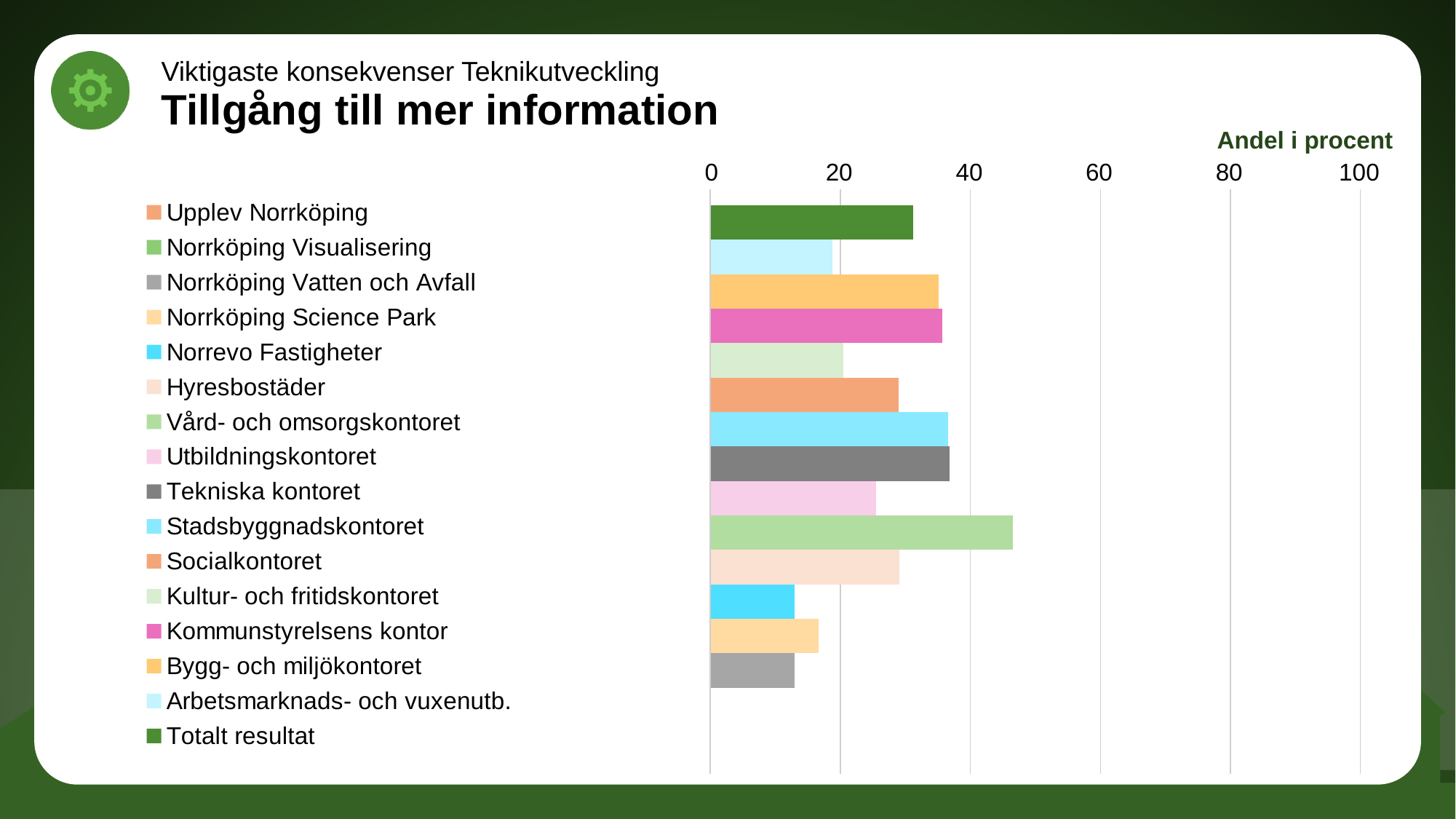
Is the value for Norrevo Fastigheter greater or less than 20? less Which series has the highest value in the chart? Vård- och omsorgskontoret Which is larger, the value for Vård- och omsorgskontoret or the value for Totalt resultat? Vård- och omsorgskontoret How many entries does the legend list? 16 What is the main title of the slide containing the chart? Tillgång till mer information Which is larger, the value for Socialkontoret or the value for Norrevo Fastigheter? Socialkontoret Is the value for Stadsbyggnadskontoret greater or less than 40? less Is the value for Totalt resultat greater or less than 20? greater What is the label shown above the horizontal axis of the chart? Andel i procent What kind of chart is shown on the slide? Bar chart